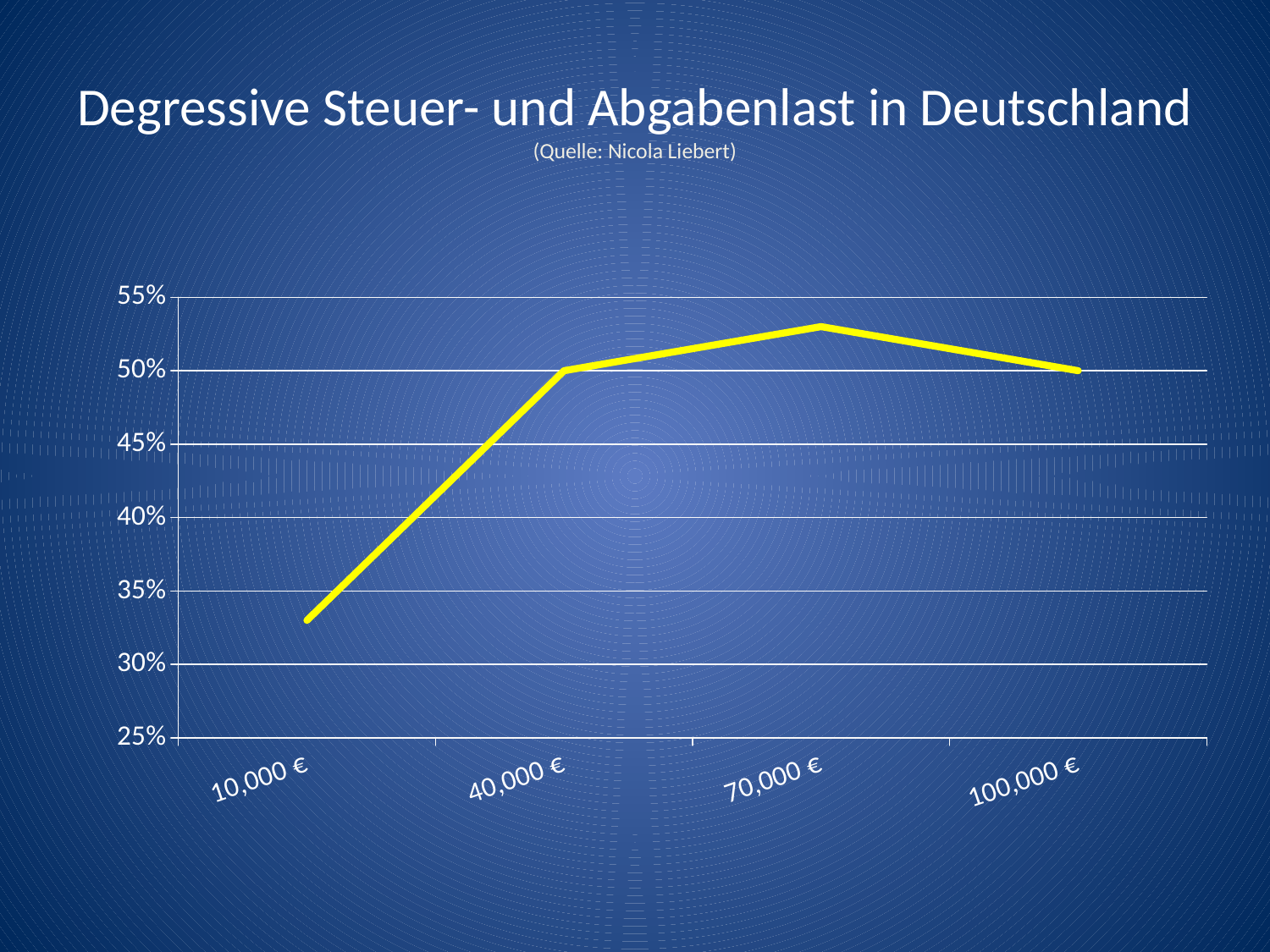
Do the values rise or fall from 10,000 € to 70,000 €? rise What is the value at 100,000 €? 50% Is the value for 70,000 € greater or less than 50%? greater Which income level has the highest value? 70,000 € Which is larger, the value at 10,000 € or the value at 40,000 €? 40,000 € Is the value for 10,000 € greater or less than 30%? greater How many data points are plotted on the line? 4 Which income level has the lowest value? 10,000 € What is the value at 40,000 €? 50% What type of chart is shown on the slide? line chart Is the value for 10,000 € greater or less than 35%? less What is the title of the chart? Degressive Steuer- und Abgabenlast in Deutschland